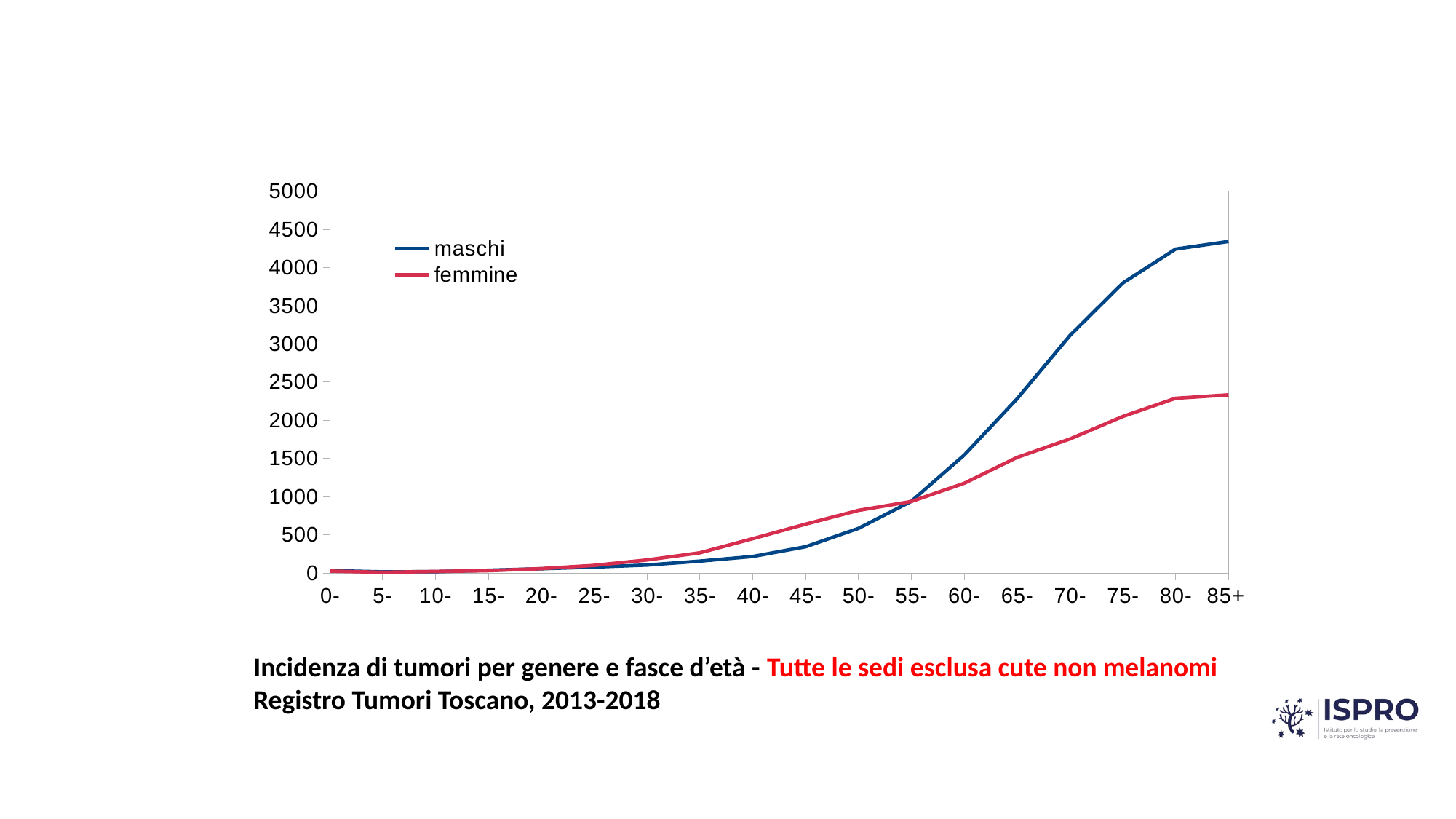
Do the values for maschi generally rise or fall as age increases along the x axis? rise Is the value for maschi at 45- greater or less than 500? less What kind of chart is shown on the slide? line chart At age group 85+, which series has the larger value, maschi or femmine? maschi Which age group has the highest value for the maschi series? 85+ How many series does the legend list? 2 At age group 45-, which series has the larger value, maschi or femmine? femmine Is the value for maschi at 85+ greater or less than 4000? greater Is the value for femmine at 85+ greater or less than 2500? less How many age groups are shown on the x axis? 18 Which age group has the highest value for the femmine series? 85+